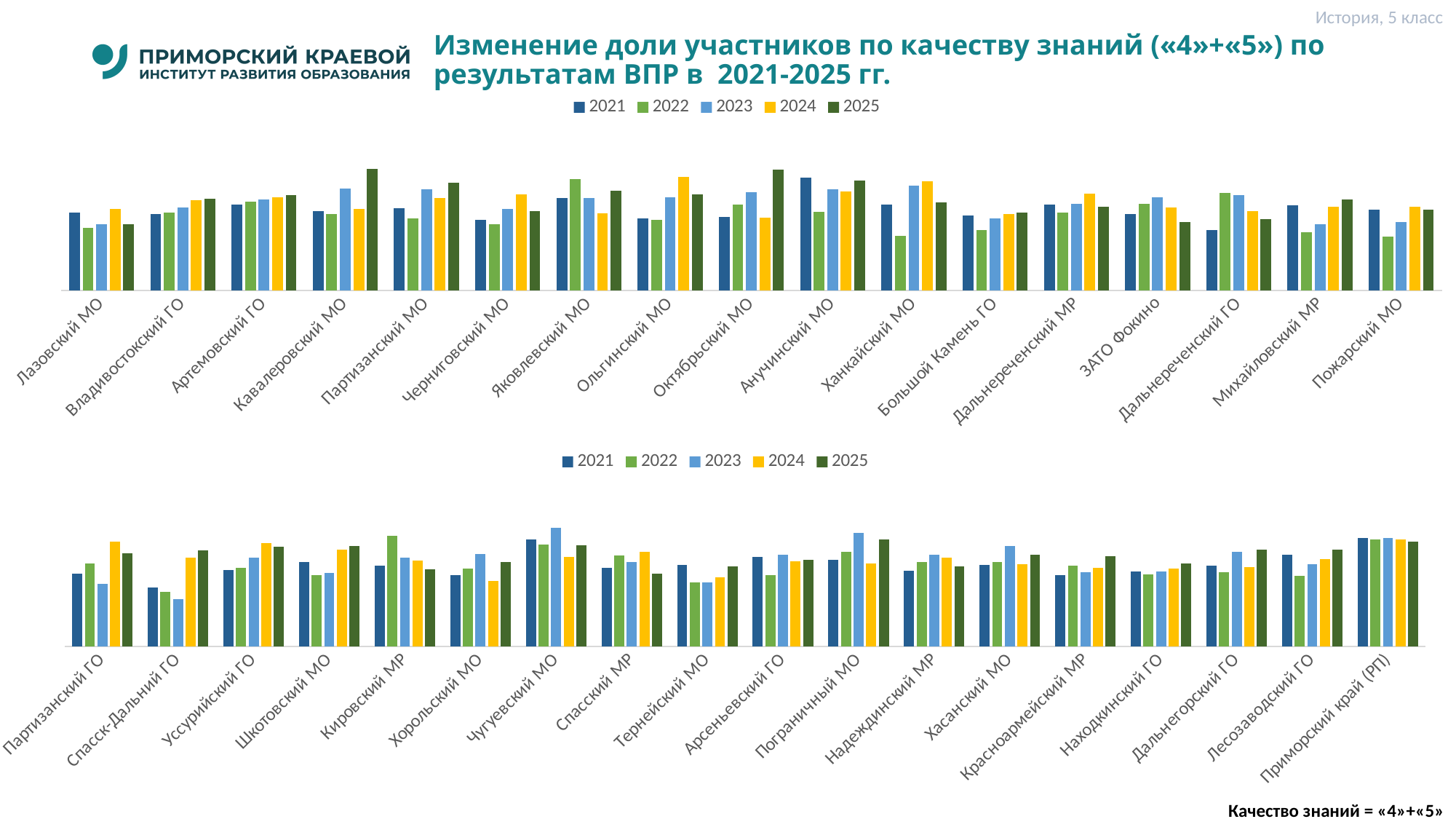
What kind of chart is the top chart on the slide? bar chart How many categories (municipalities) are shown on the x axis of the top chart? 17 In the top chart, which year has the lowest bar for Ханкайский МО? 2022 In the top chart, which year has the highest bar for Кавалеровский МО? 2025 In the top chart, which year has the highest bar for Ольгинский МО? 2024 In the bottom chart, is the 2021 value for Чугуевский МО larger or smaller than the 2021 value for Тернейский МО? larger In the top chart, is the 2025 value for Кавалеровский МО larger or smaller than the 2025 value for Лазовский МО? larger How many categories are shown on the x axis of the bottom chart? 18 How many series does the legend of the top chart list? 5 In the bottom chart, which year has the lowest bar for Спасск-Дальний ГО? 2023 Which colour represents the 2024 series in the legend of the charts? yellow In the bottom chart, which year has the highest bar for Чугуевский МО? 2023